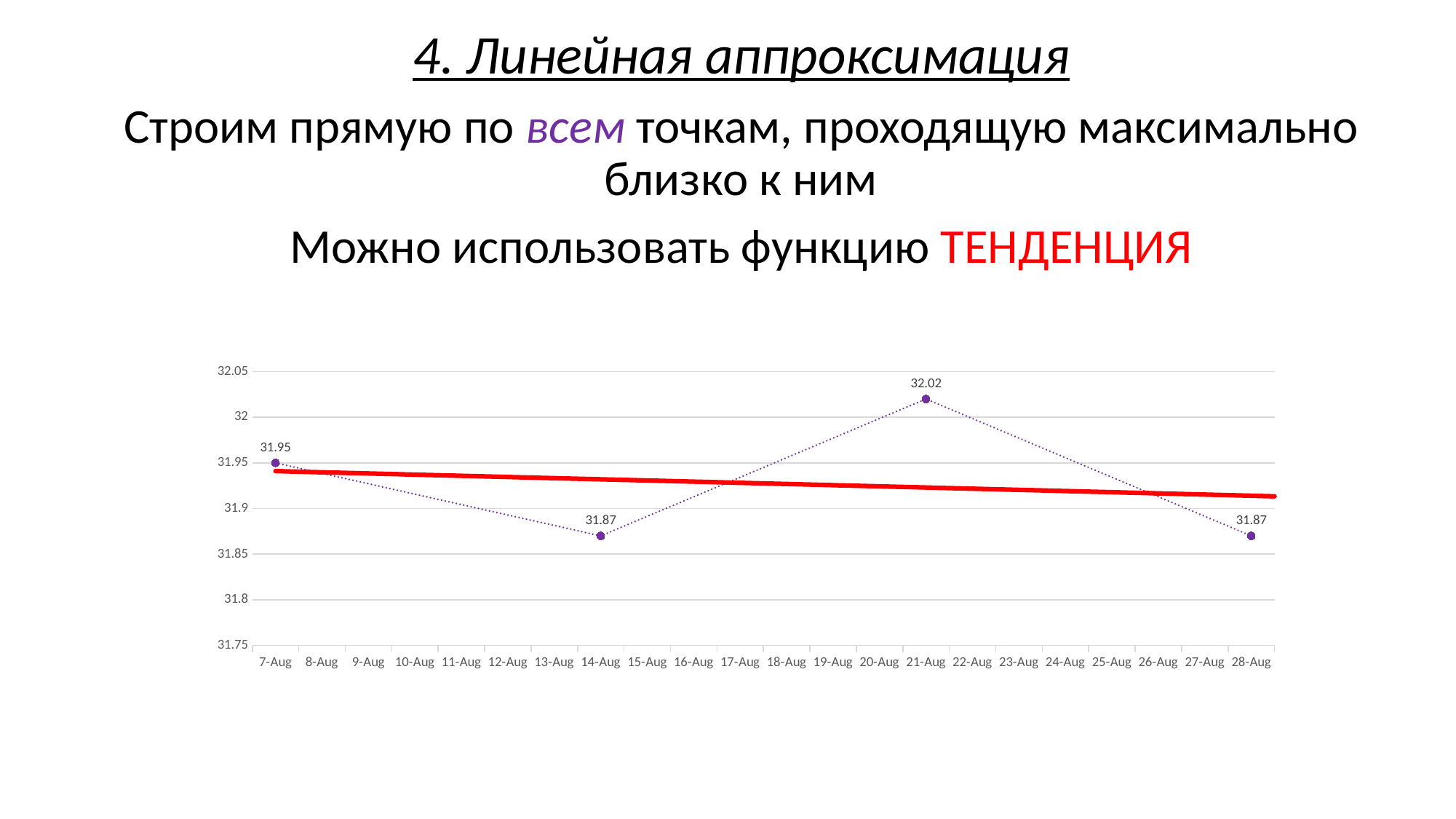
What is the value plotted for 7-Aug? 31.95 Is the value for 21-Aug greater or less than 32? greater What is the difference between the values for 7-Aug and 28-Aug? 0.08 How many labelled data points are plotted on the dotted line? 4 Does the red straight line rise or fall from left to right? fall What is the value plotted for 14-Aug? 31.87 What is the value plotted for 28-Aug? 31.87 What is the value plotted for 21-Aug? 32.02 On which date is the plotted value highest? 21-Aug What kind of chart is shown on the slide? line chart What is the difference between the values for 21-Aug and 14-Aug? 0.15 Which is larger, the value for 7-Aug or the value for 14-Aug? 7-Aug